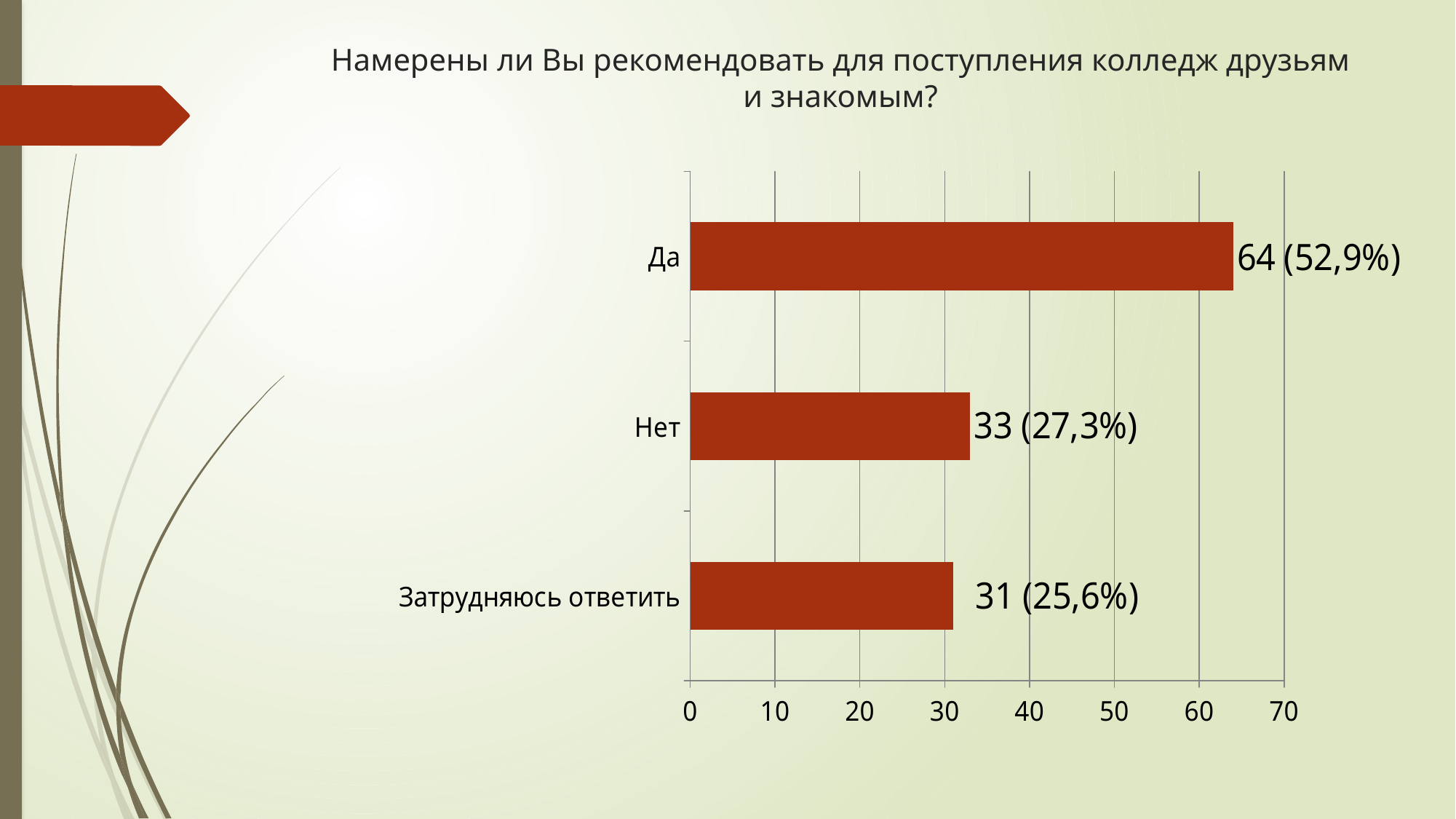
Which is larger, the value for "Да" or the value for "Нет"? Да What is the title of the chart? Намерены ли Вы рекомендовать для поступления колледж друзьям и знакомым? What is the value shown for "Затрудняюсь ответить"? 31 (25,6%) What is the difference between the counts for "Да" and "Нет"? 31 Is the value for "Да" greater or less than 60? greater What is the value shown for "Нет"? 33 (27,3%) What kind of chart is shown on the slide? bar chart Which category has the lowest value? Затрудняюсь ответить Which category has the highest value? Да How many categories are shown in the chart? 3 What is the difference between the counts for "Нет" and "Затрудняюсь ответить"? 2 What is the value shown for "Да"? 64 (52,9%)